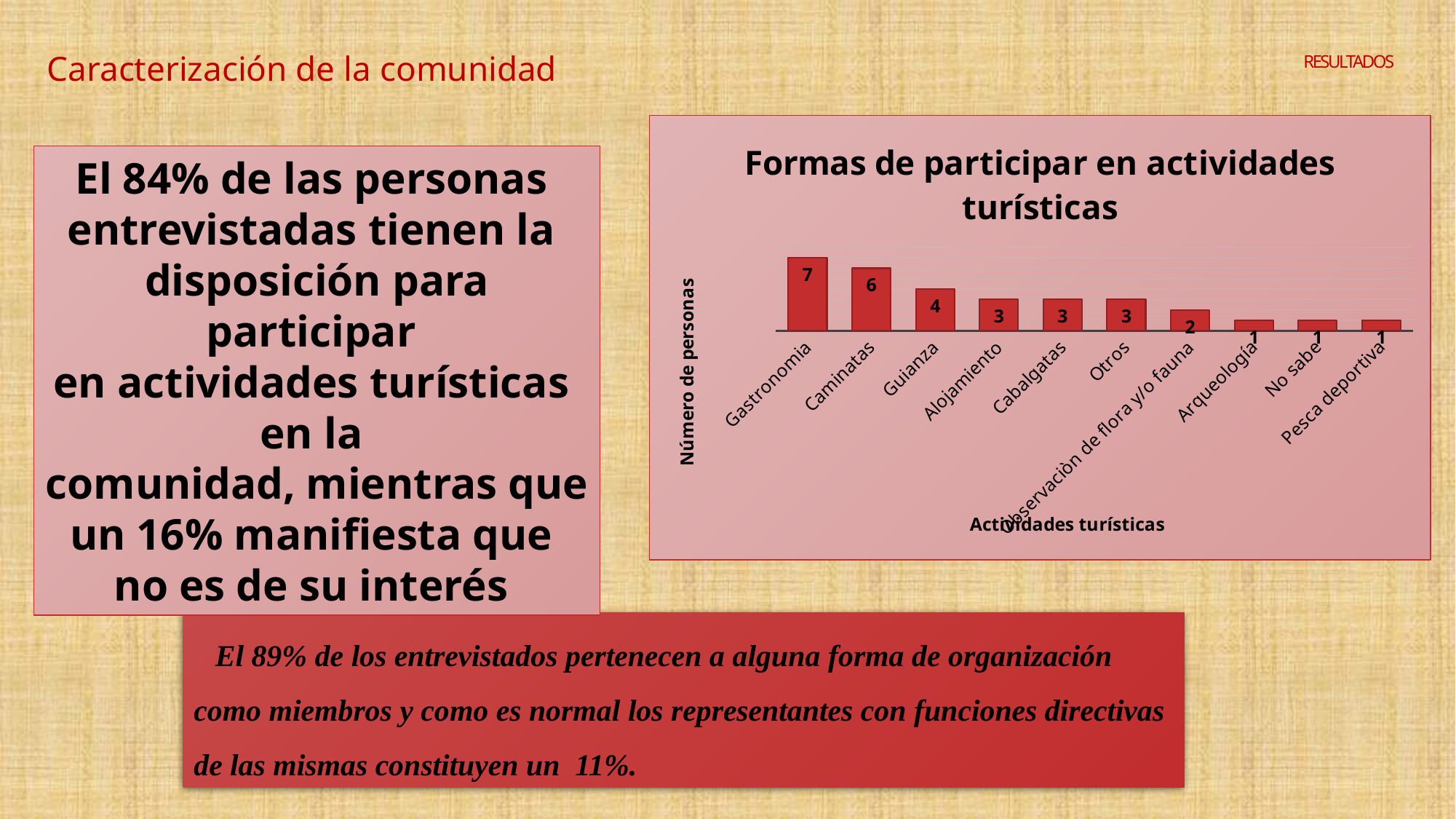
What is the value shown for Guianza? 4 What is the value for Observación de flora y/o fauna? 2 How many activity categories are shown in the chart? 10 What type of chart is shown on the slide? Bar chart What is the difference between the values for Caminatas and Pesca deportiva? 5 How many people chose Caminatas according to the chart? 6 Do the values generally rise or fall from left to right along the x axis? Fall Which is larger, the value for Guianza or the value for Alojamiento? Guianza What is the value for Gastronomía in the chart? 7 Which activity has the highest number of people in the chart? Gastronomía What is the difference between the values for Gastronomía and Caminatas? 1 What is the title of the chart? Formas de participar en actividades turísticas